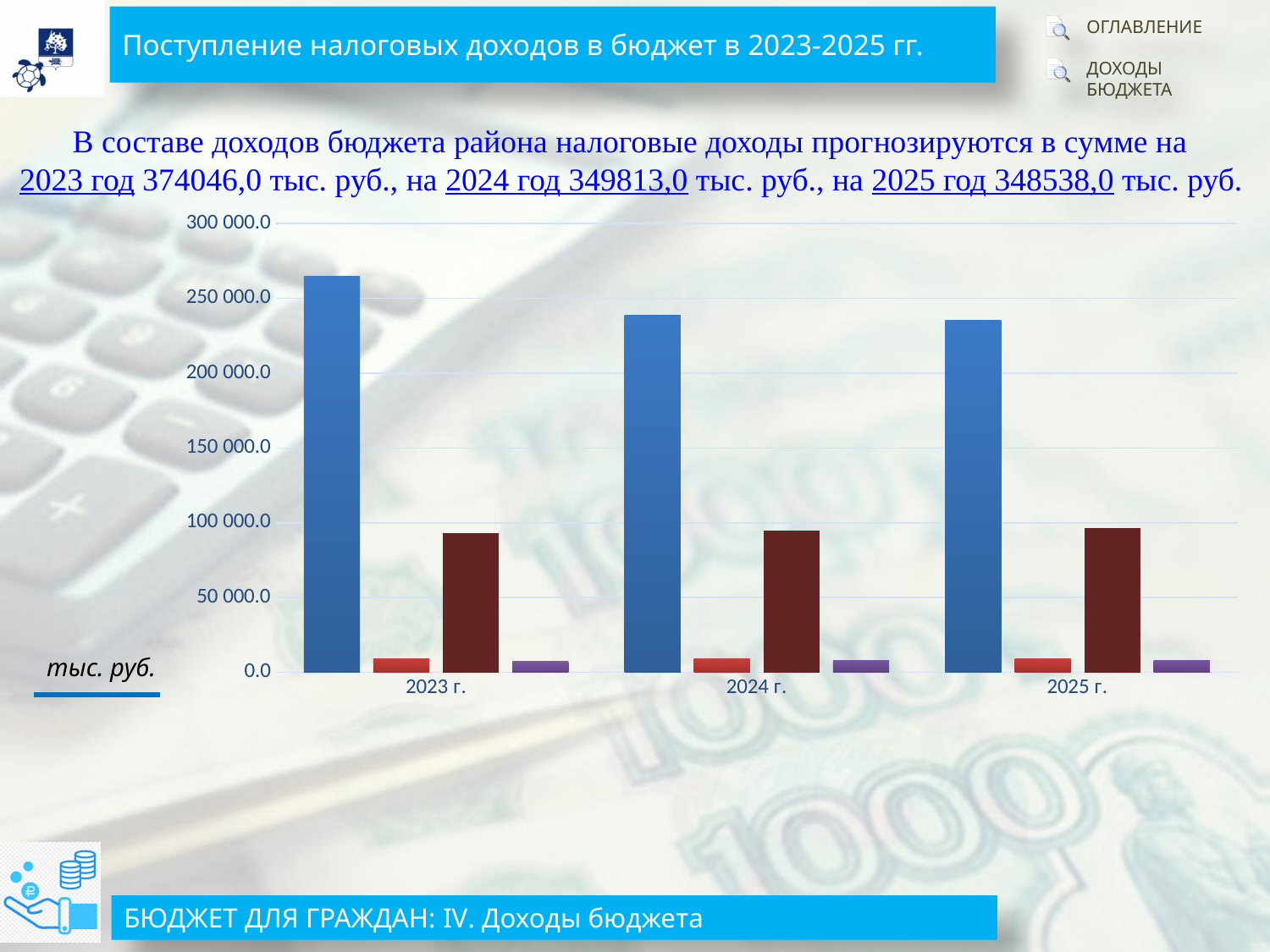
What unit label is shown next to the vertical axis of the chart? тыс. руб. How many bars are plotted for each year in the chart? 4 Which year has the highest blue bar in the chart? 2023 г. Is the value of the dark red bar for 2023 г. greater or less than 100 000.0? less How many year categories are shown on the x axis of the chart? 3 Is the value of the red bar for 2024 г. greater or less than 50 000.0? less Is the value of the blue bar for 2025 г. greater or less than 200 000.0? greater What kind of chart is shown on the slide? bar chart Which is larger: the blue bar for 2023 г. or the blue bar for 2024 г.? 2023 г.